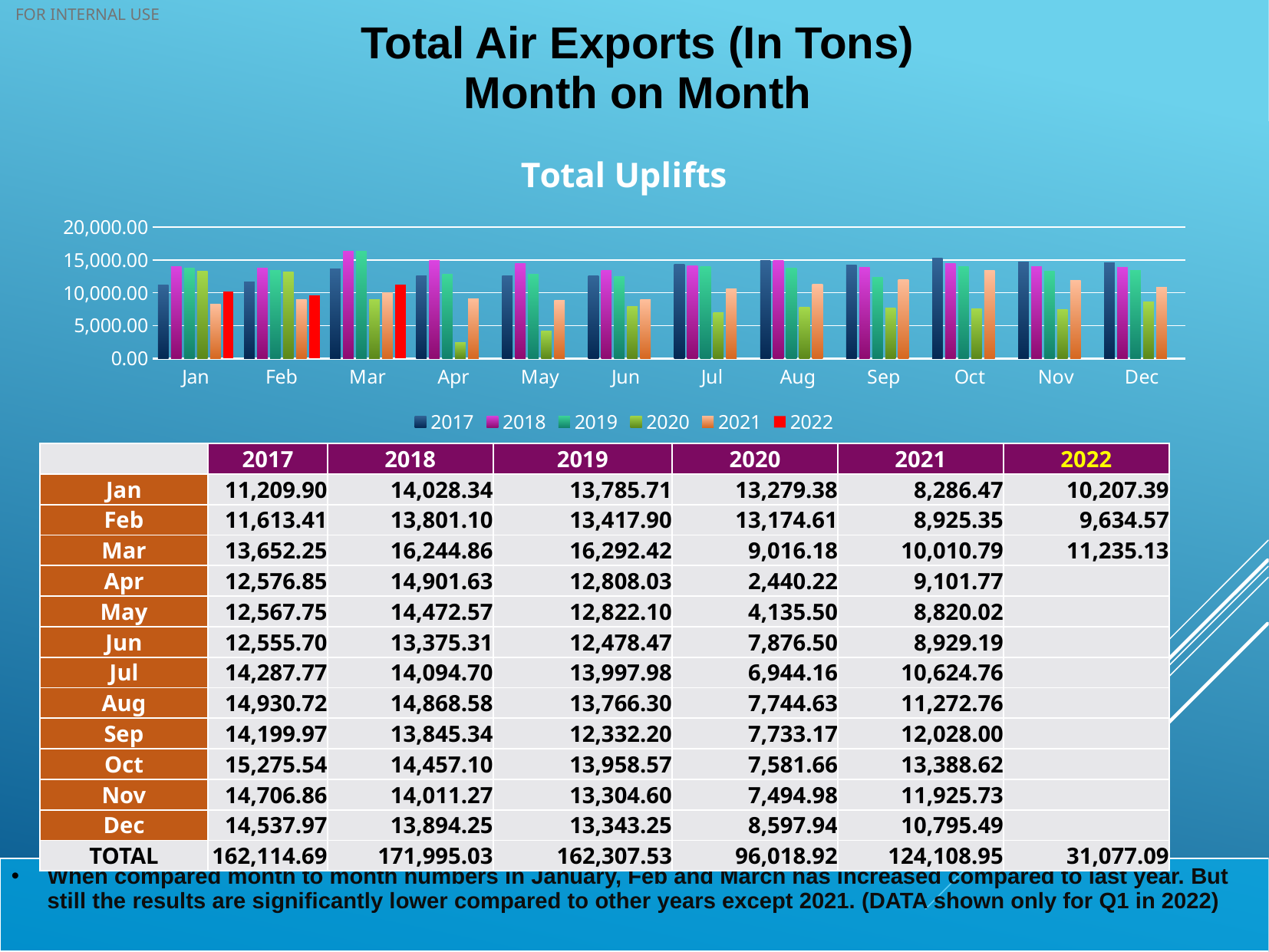
What is the difference between the 2022 and 2021 values in Jan? 1,920.92 Do the 2020 values rise or fall from Jan to Apr? fall Which month has the lowest value for 2020? Apr Which is larger in Oct, the value for 2017 or the value for 2018? 2017 What is the value for 2022 in Mar? 11,235.13 How many series does the legend of the chart list? 6 What is the value for 2020 in Apr? 2,440.22 How many months are shown along the x axis of the chart? 12 Is the value for 2020 in Apr greater or less than 5,000.00? less What kind of chart is shown on the slide? bar chart Which year has the highest TOTAL? 2018 What is the title of the chart? Total Uplifts